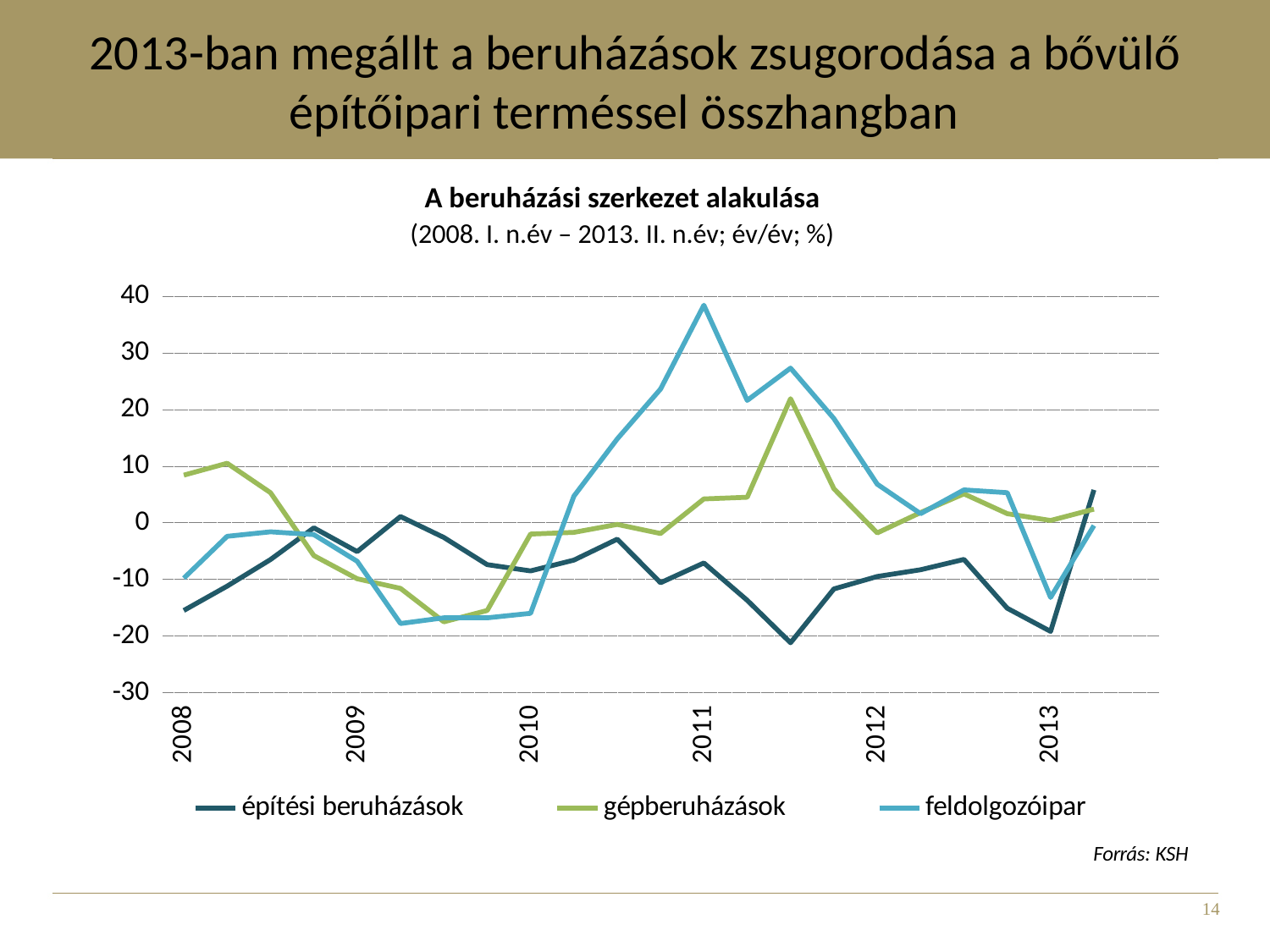
Is the peak value of feldolgozóipar in 2011 greater or less than 30? greater Is the value for gépberuházások at the start of 2008 greater or less than 5? greater Is the value for feldolgozóipar at the start of 2013 greater or less than -10? less What are the three series named in the legend? építési beruházások, gépberuházások, feldolgozóipar At the start of 2008, which series is higher: gépberuházások or építési beruházások? gépberuházások What kind of chart is shown on the slide? line chart What is the title of the chart? A beruházási szerkezet alakulása At the start of 2011, which series is higher: feldolgozóipar or építési beruházások? feldolgozóipar Which series reaches the highest value anywhere on the chart? feldolgozóipar How many series does the legend list? 3 Does the feldolgozóipar line rise or fall between the second half of 2011 and the first half of 2012? fall